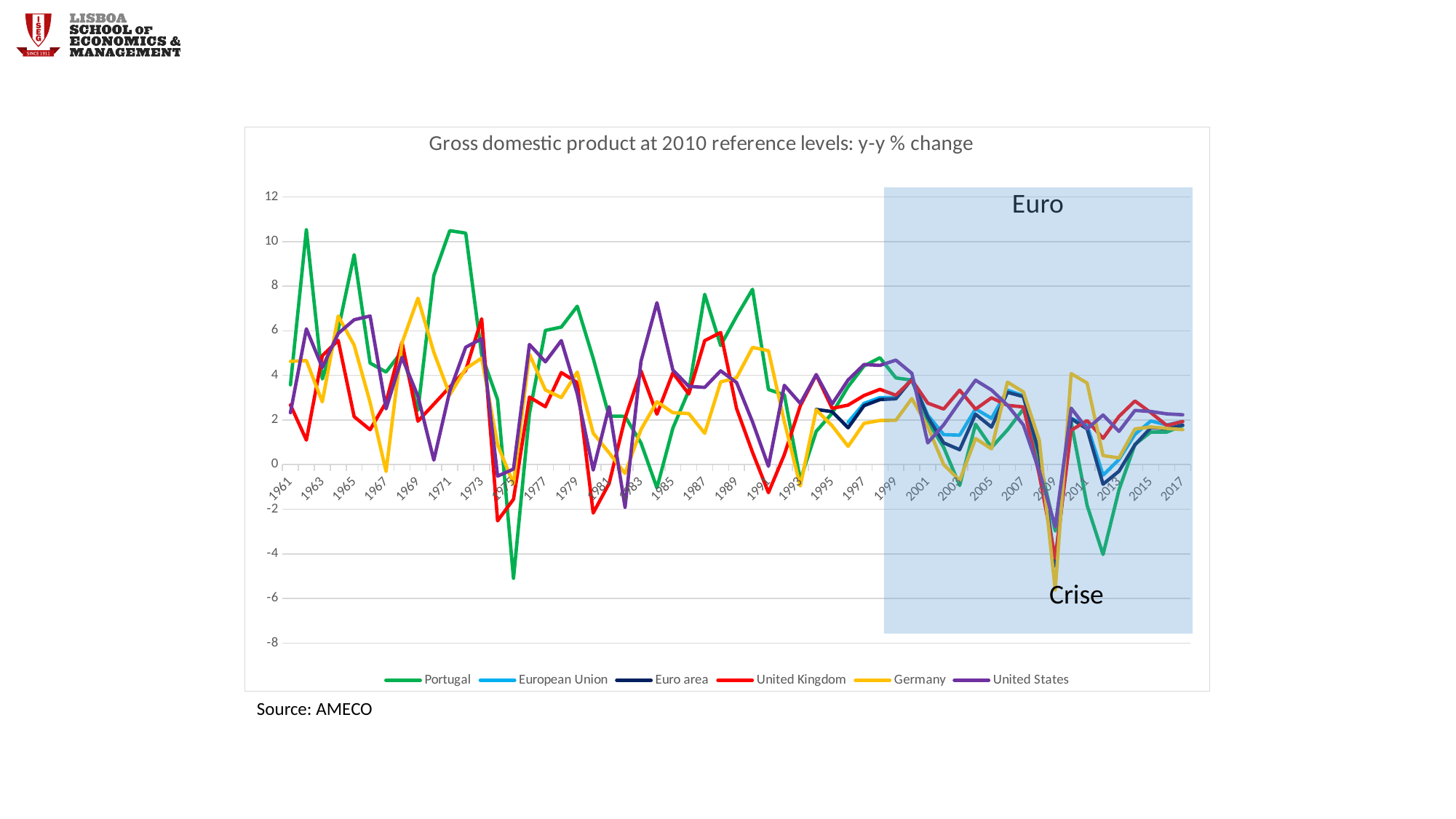
Is the value for Portugal in 1975 greater or less than -2? less Which is larger in 1984, the value for Portugal or the value for the United States? United States Does the value for Portugal rise or fall between 1971 and 1975? fall Which series has the highest value in 1962? Portugal Is the value for the United States in 1984 greater or less than 6? greater What source is cited below the chart? AMECO How many series does the legend list? 6 Is the value for Portugal in 1962 greater or less than 8? greater Which series has the lowest value in 1975? Portugal What kind of chart is shown on the slide? line chart What is the title of the chart? Gross domestic product at 2010 reference levels: y-y % change